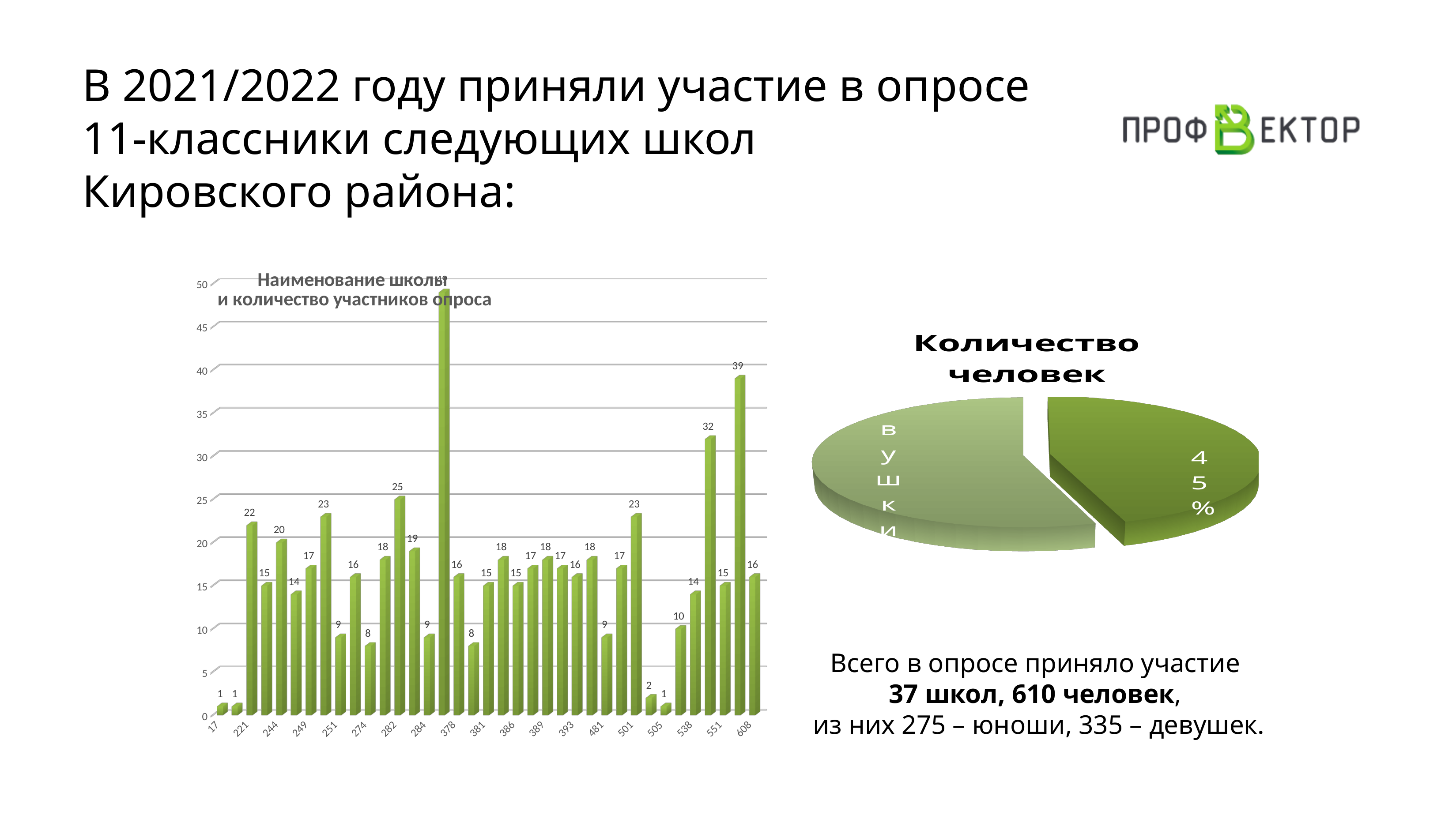
In the bar chart on the left, is the value for school 551 greater or less than 20? less What kind of chart is the chart on the left of the slide ("Наименование школы и количество участников опроса")? bar chart In the bar chart on the left, what is the value for school 282? 25 In the pie chart on the right, what percentage is printed on the right-hand slice? 45% In the bar chart on the left, what is the value for school 608? 16 In the bar chart on the left, what is the value for school 501? 23 In the bar chart on the left, what is the value for school 538? 14 What kind of chart is the chart on the right of the slide ("Количество человек")? pie chart In the bar chart on the left, what is the value for school 505? 1 In the bar chart on the left, what is the difference between the values for school 501 and school 481? 14 In the bar chart on the left, what is the value for school 17? 1 In the bar chart on the left, which has the larger value: school 282 or school 378? 282